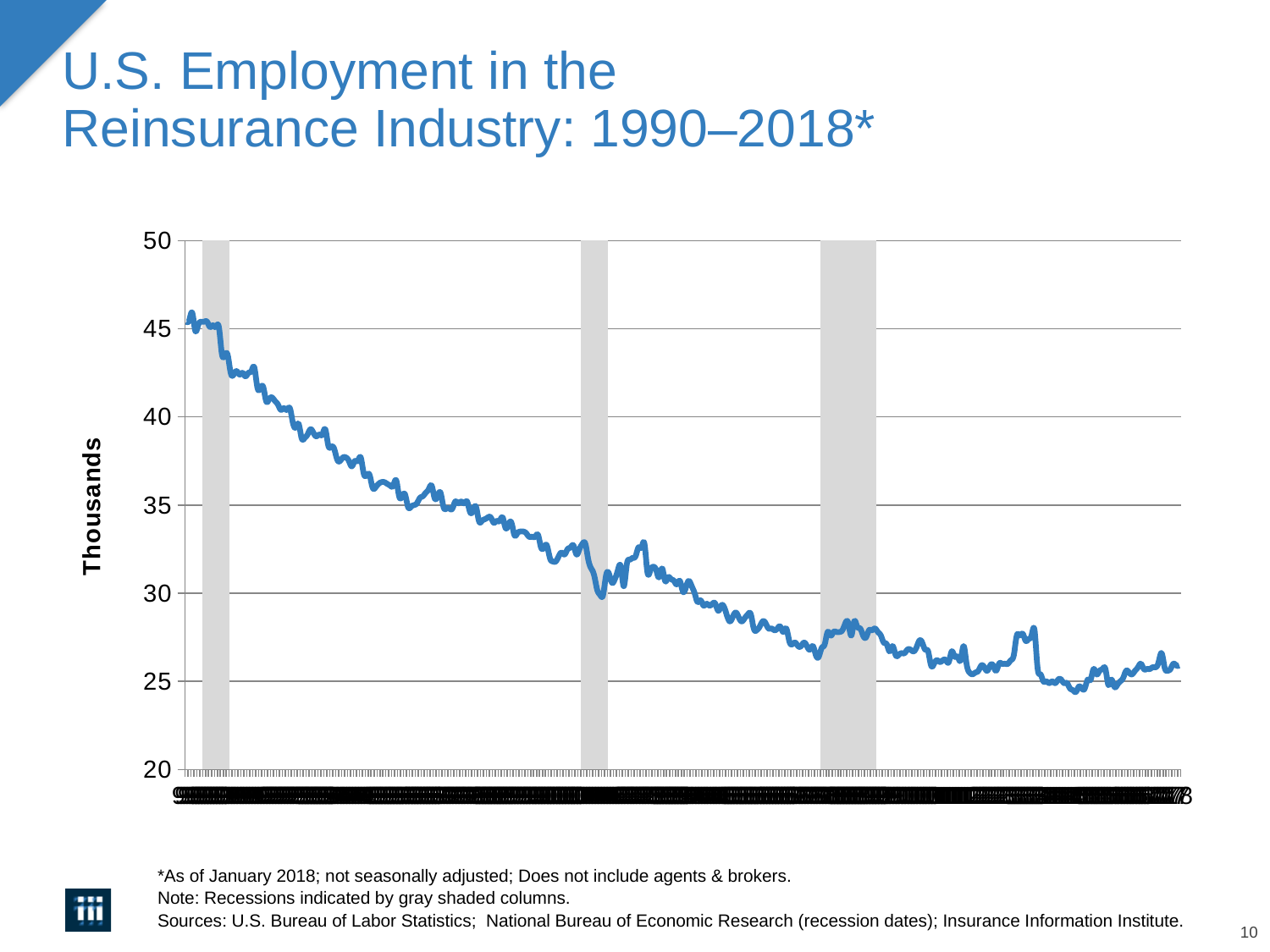
What kind of chart is shown on the slide? line chart Is the value at the left end of the line greater or less than the value at the right end of the line? greater Is the value at the end of the series (right end of the line) greater or less than 25? greater Is the highest point of the line greater or less than 50? less Is the value at the end of the series (right end of the line) greater or less than 30? less Overall, do the values rise or fall from the left of the x axis to the right? fall What is the highest value shown on the vertical axis? 50 How many gray shaded recession columns are shown on the chart? 3 What is the title of the vertical axis? Thousands